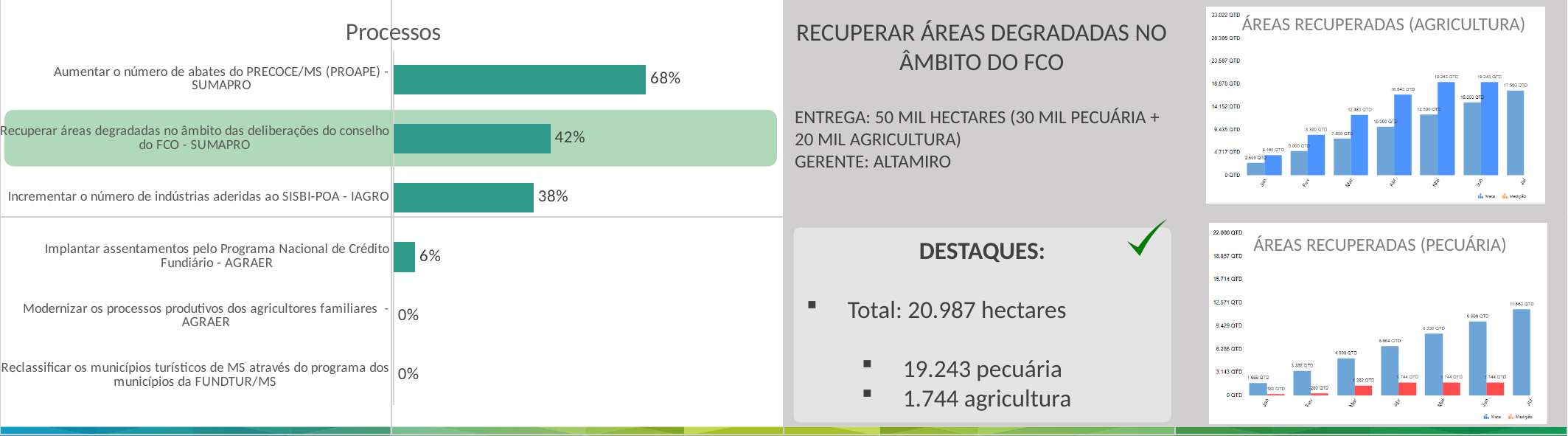
On the 'Processos' chart, what is the value for 'Incrementar o número de indústrias aderidas ao SISBI-POA - IAGRO'? 38% What kind of chart is the 'Processos' chart? Bar chart On the 'Processos' chart, what is the value for 'Aumentar o número de abates do PRECOCE/MS (PROAPE) - SUMAPRO'? 68% On the 'Processos' chart, how many categories are shown? 6 On the 'Processos' chart, how many categories have a value of 0%? 2 On the 'Processos' chart, what is the difference between the values for 'Incrementar o número de indústrias aderidas ao SISBI-POA - IAGRO' and 'Implantar assentamentos pelo Programa Nacional de Crédito Fundiário - AGRAER'? 32% On the 'Processos' chart, what is the value for 'Recuperar áreas degradadas no âmbito das deliberações do conselho do FCO - SUMAPRO'? 42% On the 'Processos' chart, which is larger: the value for 'Recuperar áreas degradadas no âmbito das deliberações do conselho do FCO - SUMAPRO' or for 'Incrementar o número de indústrias aderidas ao SISBI-POA - IAGRO'? Recuperar áreas degradadas no âmbito das deliberações do conselho do FCO - SUMAPRO On the 'Processos' chart, what is the value for 'Implantar assentamentos pelo Programa Nacional de Crédito Fundiário - AGRAER'? 6% On the 'Processos' chart, which category has the highest value? Aumentar o número de abates do PRECOCE/MS (PROAPE) - SUMAPRO On the 'Processos' chart, what is the difference between the values for 'Aumentar o número de abates do PRECOCE/MS (PROAPE) - SUMAPRO' and 'Recuperar áreas degradadas no âmbito das deliberações do conselho do FCO - SUMAPRO'? 26% What is the title of the lower chart on the right side of the slide? ÁREAS RECUPERADAS (PECUÁRIA)